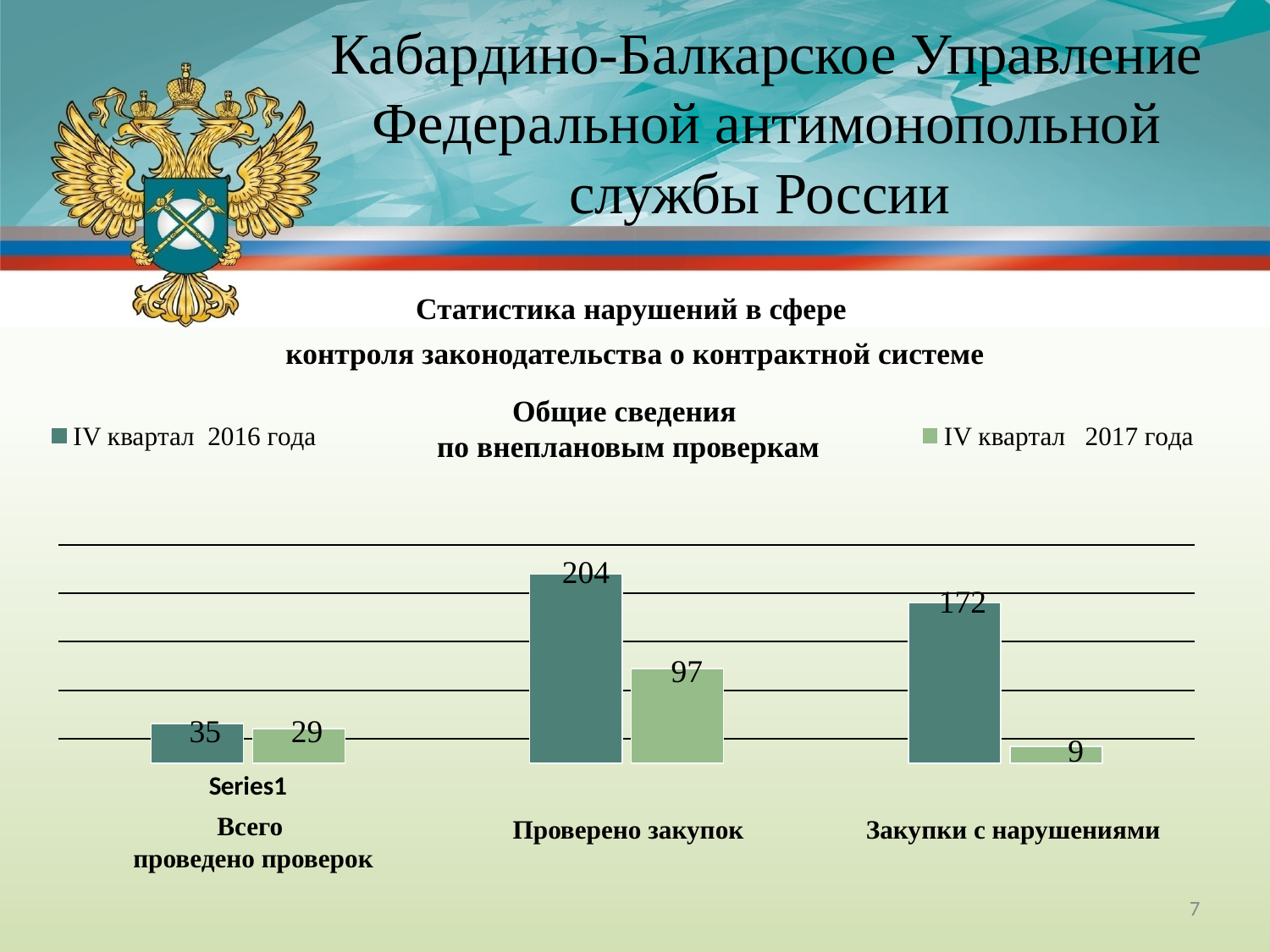
What is the difference between the "IV квартал 2016 года" and "IV квартал 2017 года" values for "Закупки с нарушениями"? 163 How many categories are shown on the x axis of the chart? 3 What is the value for "Закупки с нарушениями" in the "IV квартал 2017 года" series? 9 What is the difference between the "IV квартал 2016 года" and "IV квартал 2017 года" values for "Проверено закупок"? 107 What kind of chart is shown on the slide? Bar chart What is the value for "Проверено закупок" in the "IV квартал 2016 года" series? 204 Which is larger for "Всего проведено проверок": the "IV квартал 2016 года" value or the "IV квартал 2017 года" value? IV квартал 2016 года What is the value for "Проверено закупок" in the "IV квартал 2017 года" series? 97 Which category has the lowest value in the "IV квартал 2017 года" series? Закупки с нарушениями How many series does the chart's legend list? 2 What is the value for "Всего проведено проверок" in the "IV квартал 2016 года" series? 35 Which category has the highest value in the "IV квартал 2016 года" series? Проверено закупок